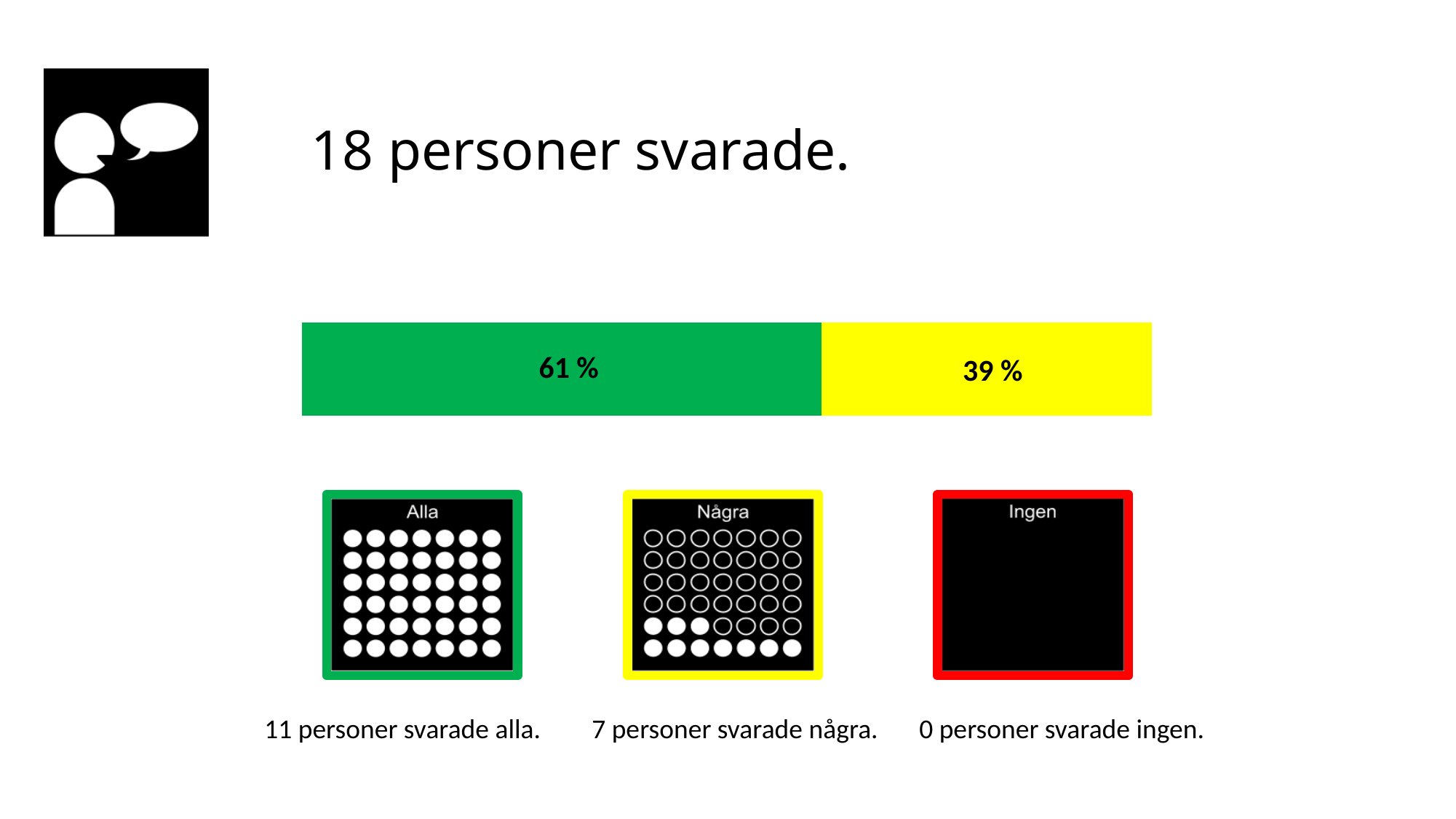
What value is printed on the green segment of the bar? 61 % What kind of chart is shown in the middle of the slide? bar chart What is the total of the two segments in the stacked bar? 100 % What value is printed on the yellow segment of the bar? 39 % Which segment of the bar has the highest value? the green segment (61 %) How many segments does the stacked bar contain? 2 What is the difference between the green segment (61 %) and the yellow segment (39 %)? 22 % What is the title text at the top of the slide? 18 personer svarade. Which segment of the bar is larger, the green one or the yellow one? green Is the value of the yellow segment greater or less than 50 %? less According to the caption under the green box, how many people answered 'alla'? 11 Which segment of the bar has the lowest value? the yellow segment (39 %)